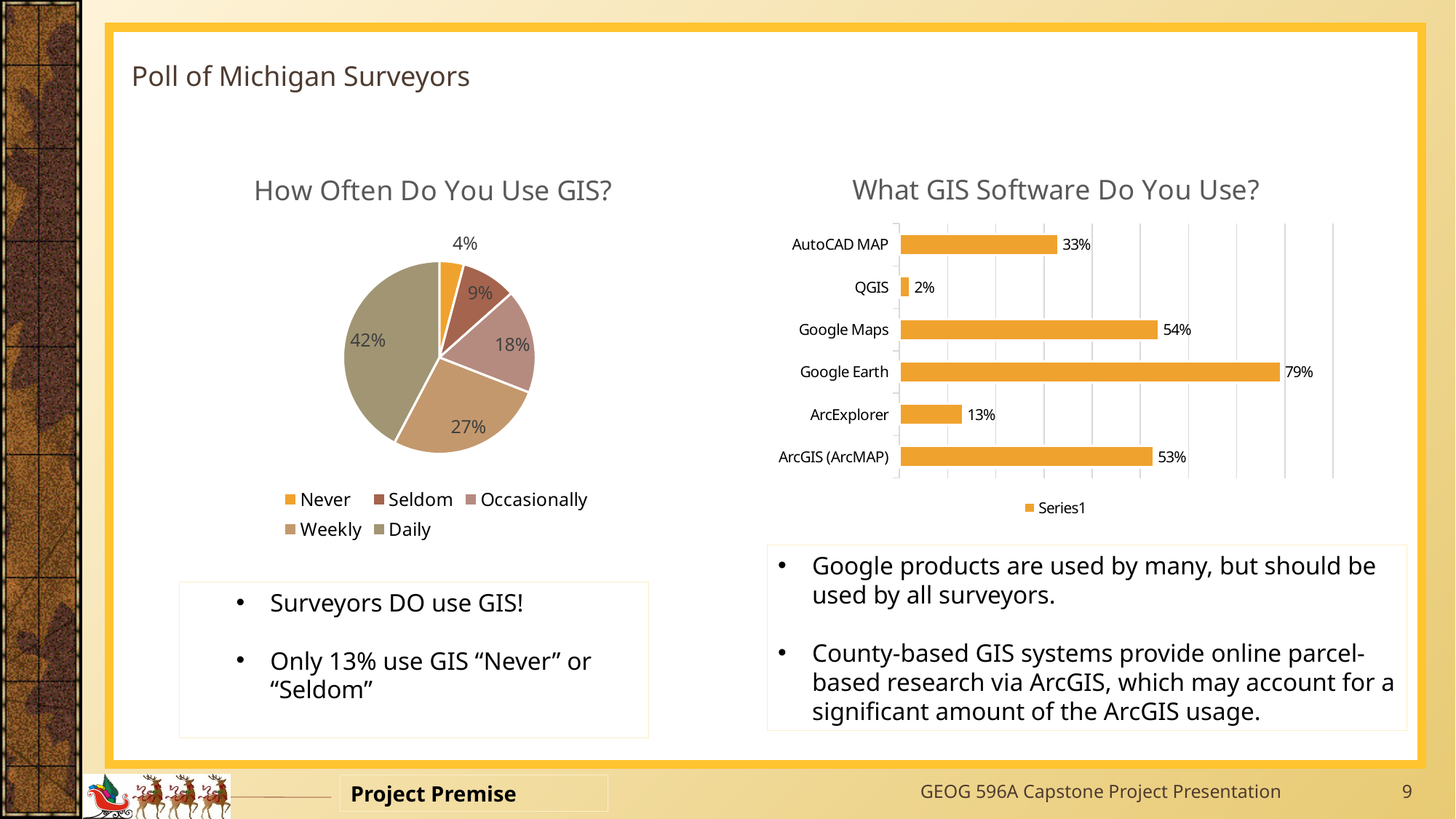
In the 'What GIS Software Do You Use?' chart, how many software categories are shown? 6 In the 'What GIS Software Do You Use?' chart, what is the value for Google Earth? 79% In the 'What GIS Software Do You Use?' chart, which software has the highest value? Google Earth In the 'How Often Do You Use GIS?' pie chart, what percentage of surveyors use GIS daily? 42% In the 'What GIS Software Do You Use?' chart, which software has the lowest value? QGIS In the 'What GIS Software Do You Use?' chart, what is the difference between Google Maps and AutoCAD MAP? 21% In the 'How Often Do You Use GIS?' pie chart, which category has the smallest slice? Never In the 'What GIS Software Do You Use?' chart, which is larger: ArcGIS (ArcMAP) or ArcExplorer? ArcGIS (ArcMAP) In the 'How Often Do You Use GIS?' pie chart, what is the combined share of 'Never' and 'Seldom'? 13% In the 'How Often Do You Use GIS?' pie chart, what share is labelled for 'Weekly'? 27% What kind of chart is 'What GIS Software Do You Use?' Bar chart In the 'How Often Do You Use GIS?' pie chart, how many categories does the legend list? 5